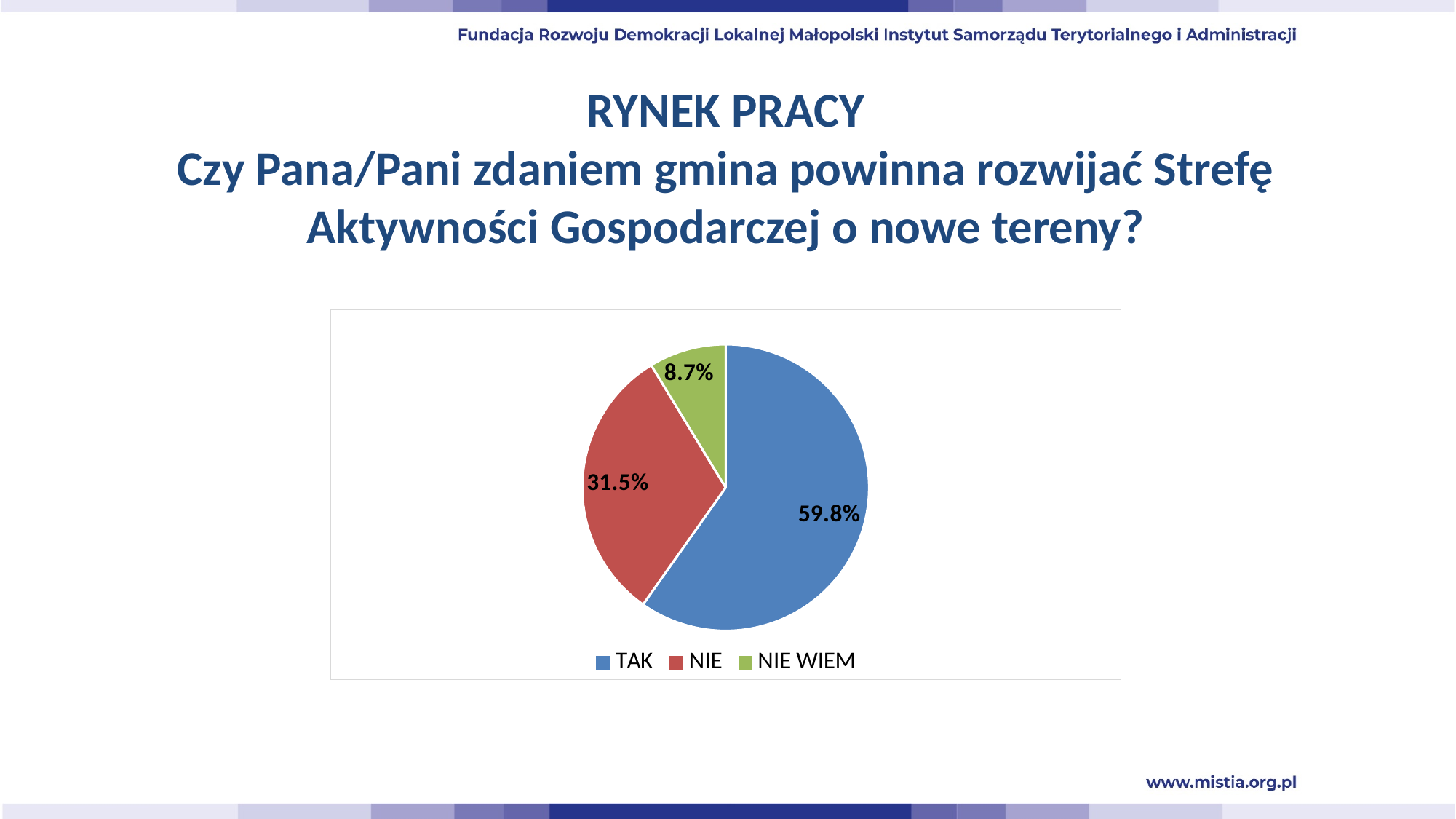
What type of chart is shown on the slide? pie chart Which answer has the smallest share of the pie? NIE WIEM What colour is the slice for NIE WIEM? green What percentage of respondents answered NIE WIEM? 8.7% What percentage of respondents answered NIE? 31.5% What percentage of respondents answered TAK? 59.8% What is the difference in percentage points between NIE and NIE WIEM? 22.8 How many slices does the pie chart have? 3 What is the difference in percentage points between TAK and NIE? 28.3 Which answer has the largest share of the pie? TAK How many entries does the legend list? 3 Which is larger, the share for NIE or the share for NIE WIEM? NIE